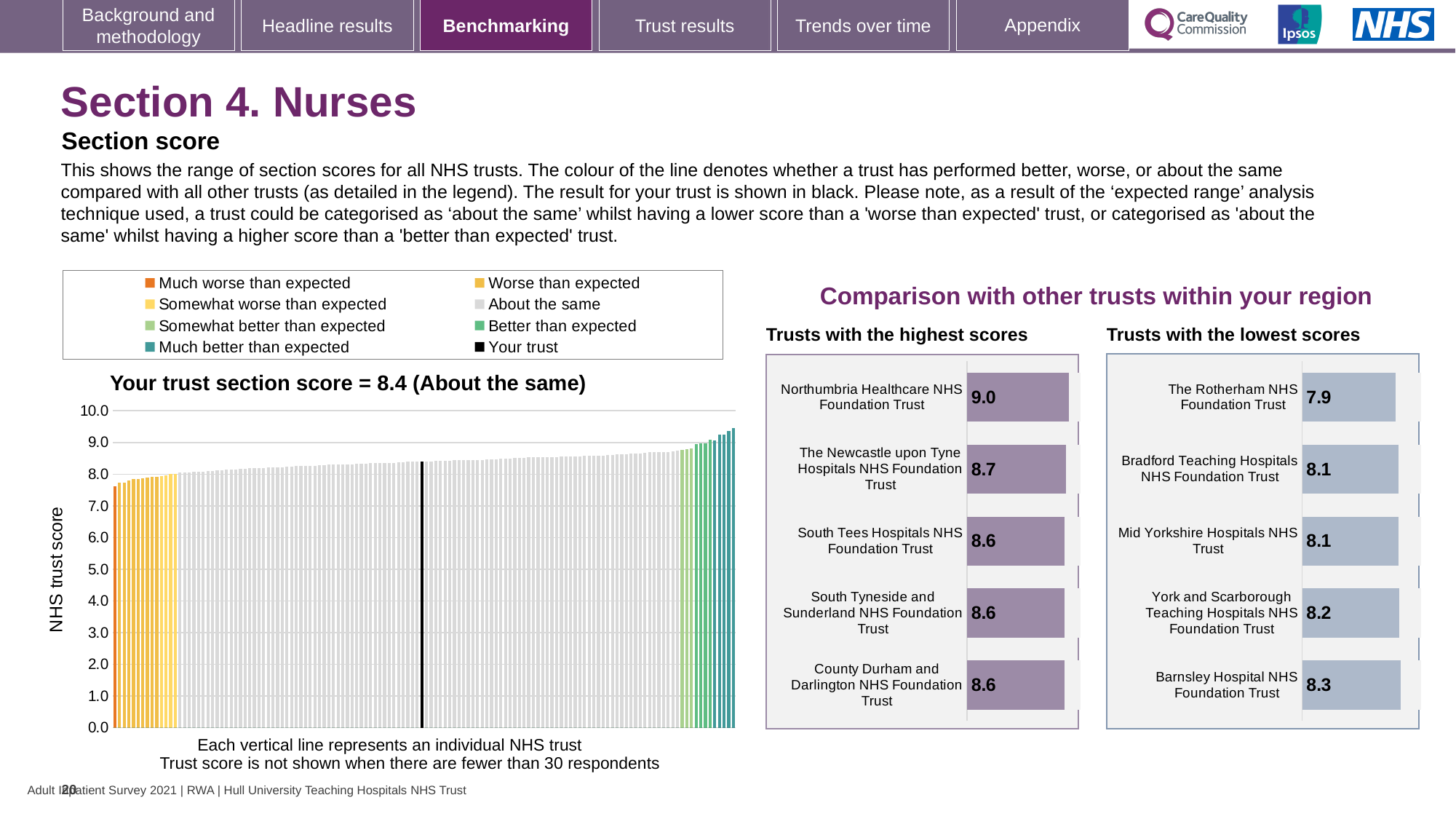
In the 'Trusts with the highest scores' chart, what is the difference between the scores of Northumbria Healthcare NHS Foundation Trust and The Newcastle upon Tyne Hospitals NHS Foundation Trust? 0.3 In the 'Trusts with the highest scores' chart, what is the score for Northumbria Healthcare NHS Foundation Trust? 9.0 In the 'Your trust section score' chart, is the value of the lowest bar greater or less than 8.0? less In the 'Your trust section score' chart, what is the section score for your trust? 8.4 In the 'Trusts with the lowest scores' chart, which has the larger score: Barnsley Hospital NHS Foundation Trust or York and Scarborough Teaching Hospitals NHS Foundation Trust? Barnsley Hospital NHS Foundation Trust What kind of chart is the 'Your trust section score' chart? bar chart In the 'Your trust section score' chart, is the value of the highest bar greater or less than 9.0? greater How many trusts are shown in the 'Trusts with the lowest scores' chart? 5 In the 'Trusts with the highest scores' chart, which trust has the highest score? Northumbria Healthcare NHS Foundation Trust How many entries does the legend above the 'Your trust section score' chart list? 8 In the 'Your trust section score' chart, what category is your trust placed in? About the same In the 'Trusts with the lowest scores' chart, which trust has the lowest score? The Rotherham NHS Foundation Trust